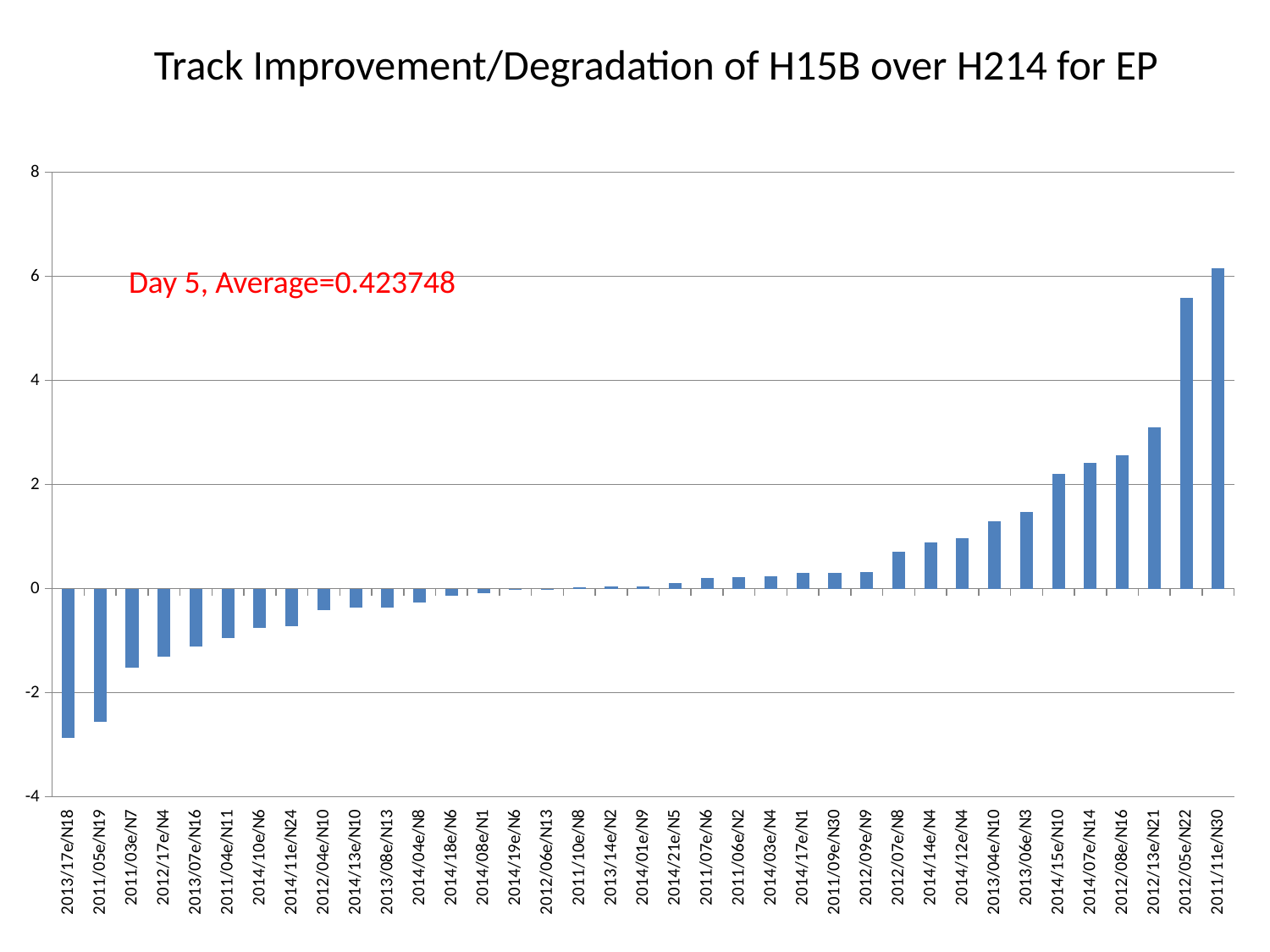
Which category has the highest value? 2011/11e/N30 How many categories (bars) are plotted on the chart? 37 Which has the larger value, 2012/05e/N22 or 2012/13e/N21? 2012/05e/N22 Do the values rise or fall moving from left to right along the x axis? rise What kind of chart is shown on the slide? bar chart Is the value for 2013/17e/N18 greater or less than -2? less Is the value for 2011/03e/N7 greater or less than -1? less What average value is stated in the red text on the chart? 0.423748 Is the value for 2012/13e/N21 greater or less than 2? greater Which category has the lowest value? 2013/17e/N18 What is the title of the chart? Track Improvement/Degradation of H15B over H214 for EP